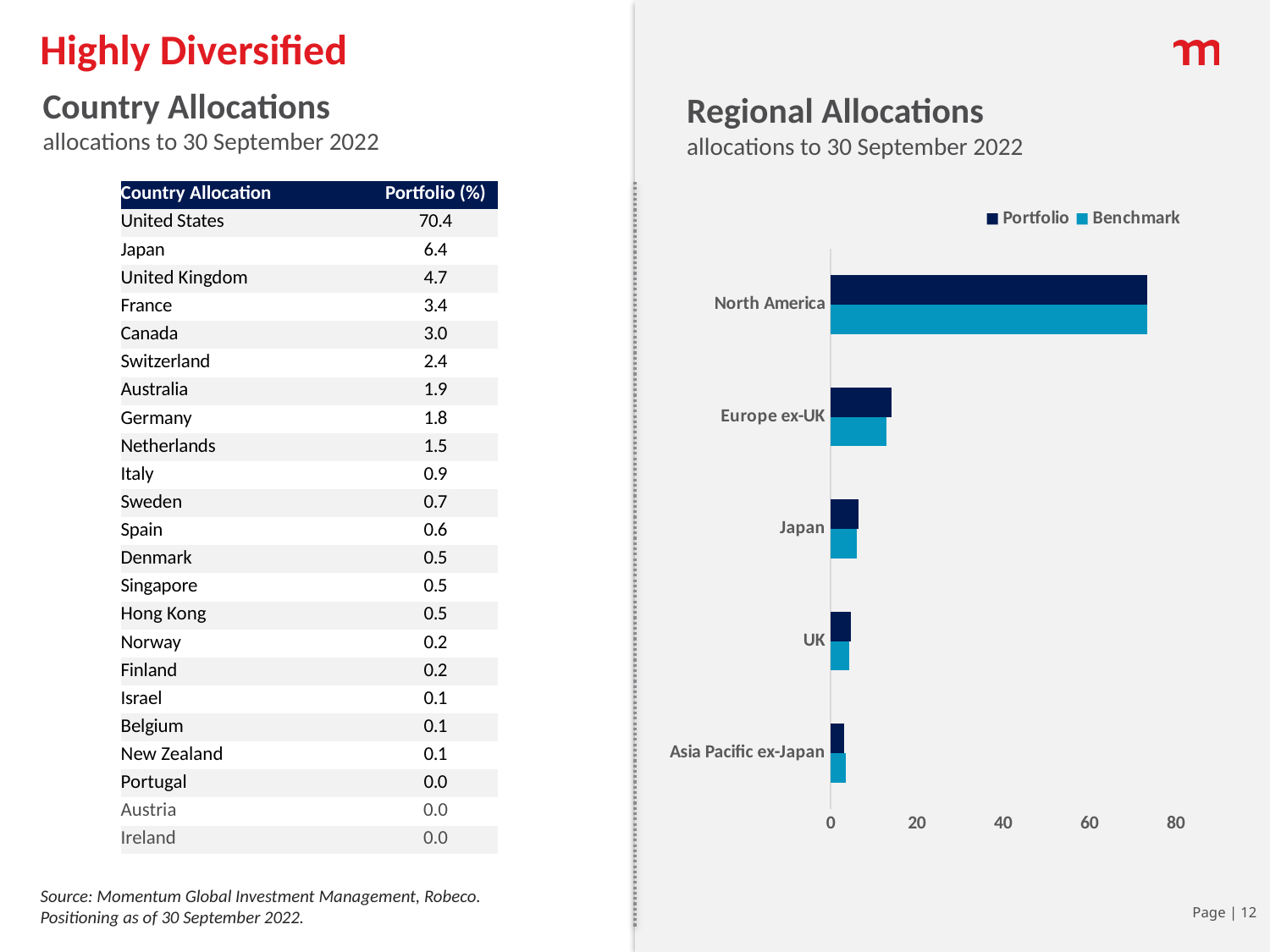
How many regions are plotted in the Regional Allocations chart? 5 In the Regional Allocations chart, is the Portfolio value for North America greater or less than 60? greater What is the subtitle shown under the Regional Allocations chart title? allocations to 30 September 2022 What kind of chart is shown under the title "Regional Allocations"? bar chart In the Regional Allocations chart, which region has the lowest Portfolio value? Asia Pacific ex-Japan In the Regional Allocations chart, which region has the highest Portfolio value? North America In the Regional Allocations chart, which is larger: the Benchmark value for Europe ex-UK or the Benchmark value for UK? Europe ex-UK In the Regional Allocations chart, is the Benchmark value for Japan greater or less than 20? less In the Regional Allocations chart, is the Portfolio value for Europe ex-UK greater or less than 20? less What are the two legend entries in the Regional Allocations chart? Portfolio and Benchmark In the Regional Allocations chart, which is larger: the Portfolio value for North America or the Portfolio value for Europe ex-UK? North America How many series does the legend of the Regional Allocations chart list? 2